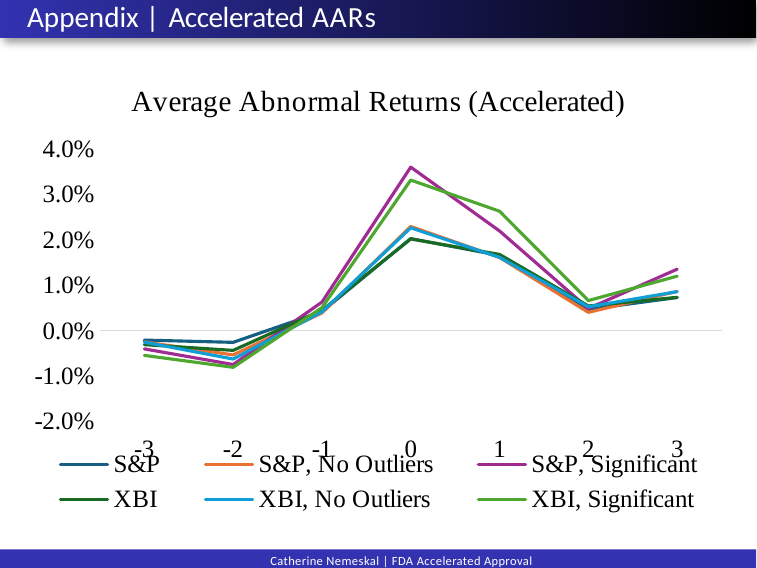
Is the value for S&P, Significant at day 0 greater or less than 3.0%? greater At day 1, which is larger: XBI, Significant or S&P? XBI, Significant What type of chart is shown on the slide? Line chart Is the value for S&P, No Outliers at day 2 greater or less than 1.0%? less What is the title of the chart? Average Abnormal Returns (Accelerated) Is the value for XBI, Significant at day 1 greater or less than 2.0%? greater Which series has the highest value at day 0? S&P, Significant How many points are on the x axis of the chart? 7 How many series does the legend list? 6 Do the values for XBI rise or fall from day -2 to day 0? rise Do the values for S&P, Significant rise or fall from day 0 to day 2? fall